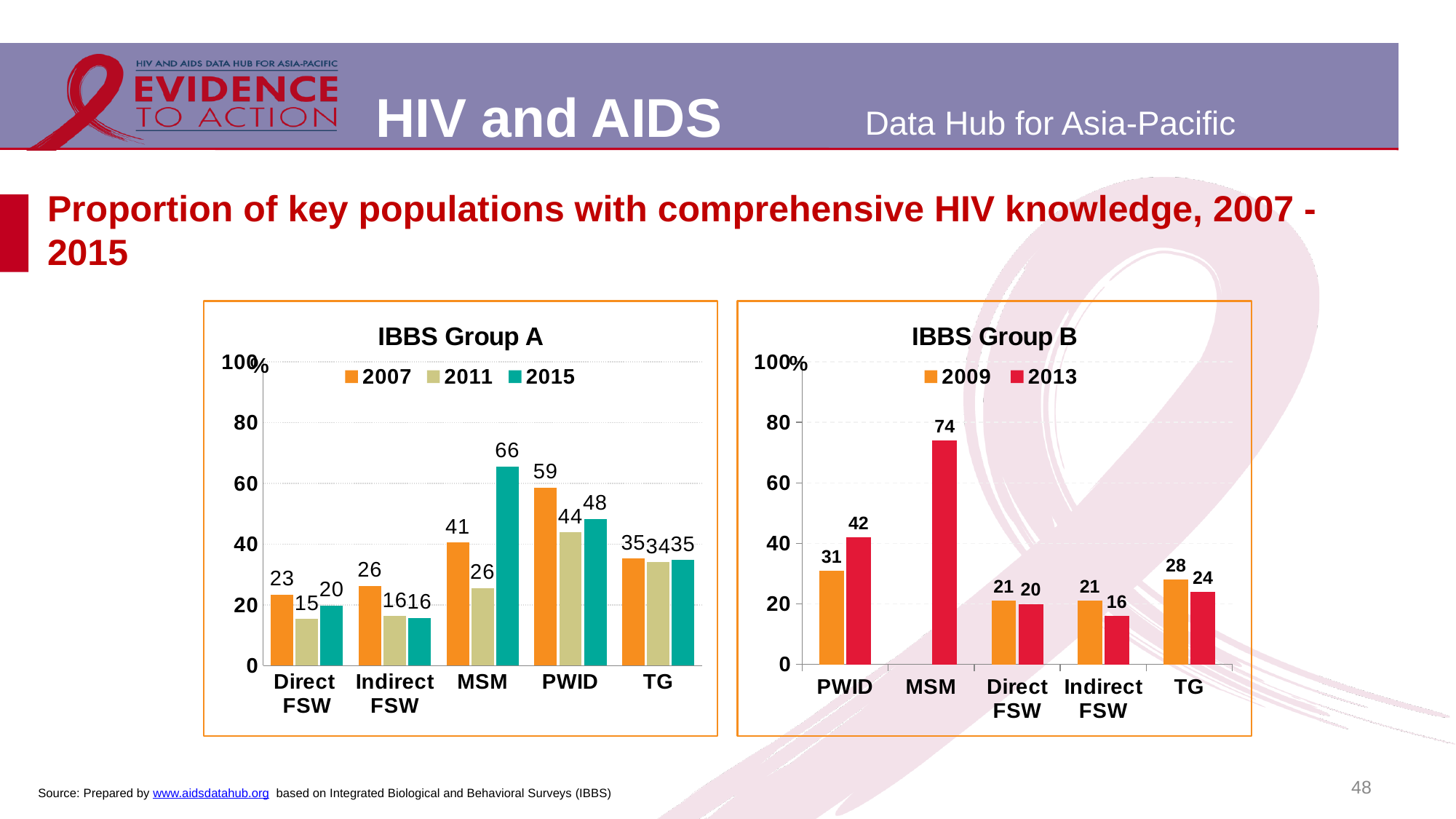
In the IBBS Group B chart, what is the value for MSM in 2013? 74 In the IBBS Group B chart, is the 2009 value for TG larger or smaller than the 2013 value for TG? larger What kind of chart is the IBBS Group B chart? bar chart In the IBBS Group A chart, what is the difference between the 2015 and 2011 values for MSM? 40 In the IBBS Group B chart, what is the difference between the 2013 and 2009 values for PWID? 11 How many series does the legend of the IBBS Group A chart list? 3 How many categories are shown on the x axis of the IBBS Group B chart? 5 In the IBBS Group A chart, what is the value for PWID in 2007? 59 In the IBBS Group A chart, which category has the lowest 2011 value? Direct FSW In the IBBS Group A chart, which category has the highest 2015 value? MSM In the IBBS Group A chart, what is the value for MSM in 2015? 66 In the IBBS Group B chart, what is the value for Indirect FSW in 2013? 16